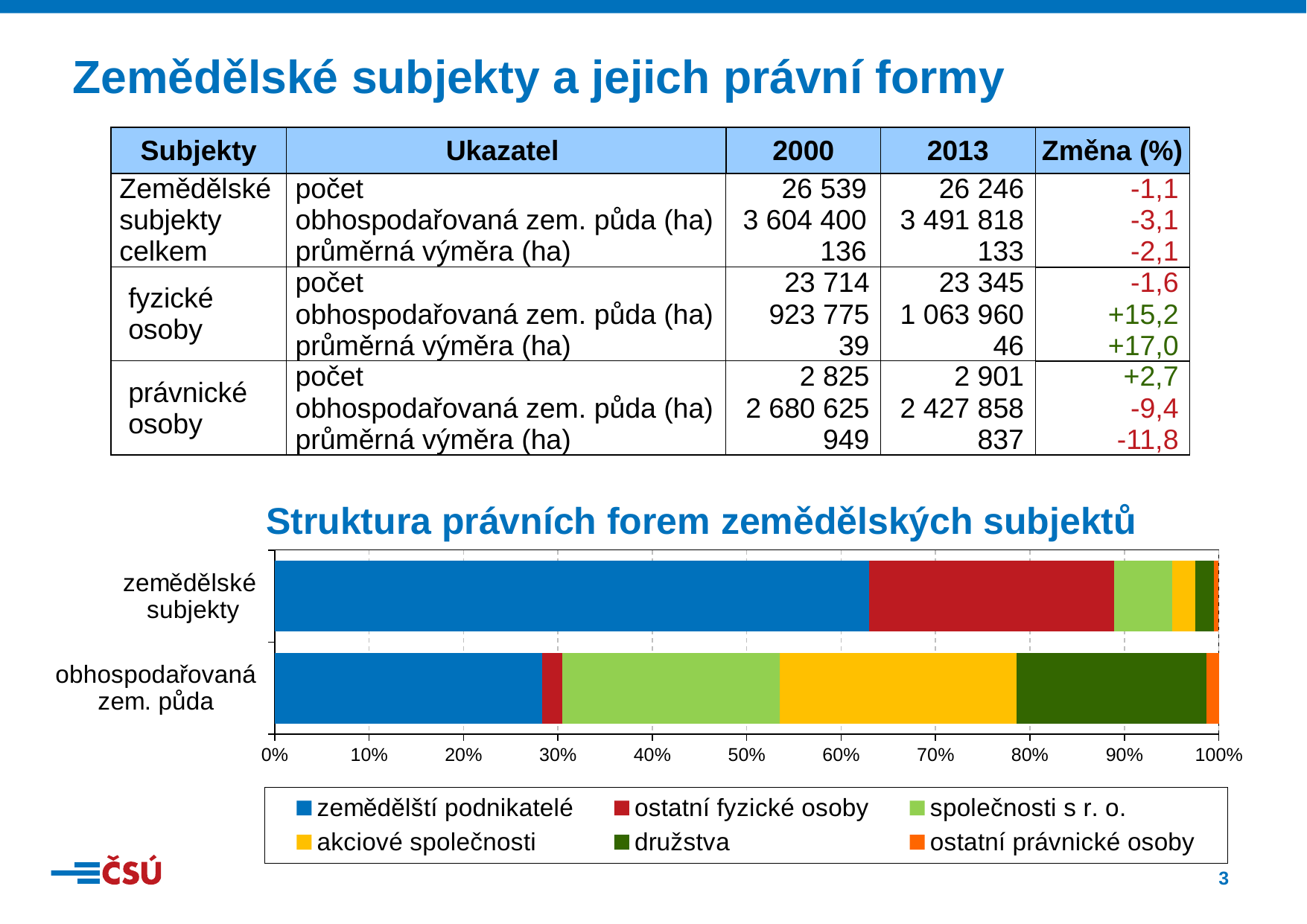
In the chart, which legal form has the largest share in the 'zemědělské subjekty' bar? zemědělští podnikatelé What kind of chart is shown under the title 'Struktura právních forem zemědělských subjektů'? stacked bar chart In the chart, is the share of 'zemědělští podnikatelé' in the 'zemědělské subjekty' bar greater or less than 60%? greater In the chart, is the share of 'družstva' larger in the 'zemědělské subjekty' bar or in the 'obhospodařovaná zem. půda' bar? obhospodařovaná zem. půda In the chart, is the share of 'družstva' in the 'obhospodařovaná zem. půda' bar greater or less than 10%? greater What colour represents 'družstva' in the chart's legend? dark green In the chart, is the share of 'zemědělští podnikatelé' in the 'obhospodařovaná zem. půda' bar greater or less than 30%? less How many categories (bars) does the chart 'Struktura právních forem zemědělských subjektů' show? 2 How many series does the legend of the chart 'Struktura právních forem zemědělských subjektů' list? 6 In the chart, is the share of 'zemědělští podnikatelé' larger in the 'zemědělské subjekty' bar or in the 'obhospodařovaná zem. půda' bar? zemědělské subjekty